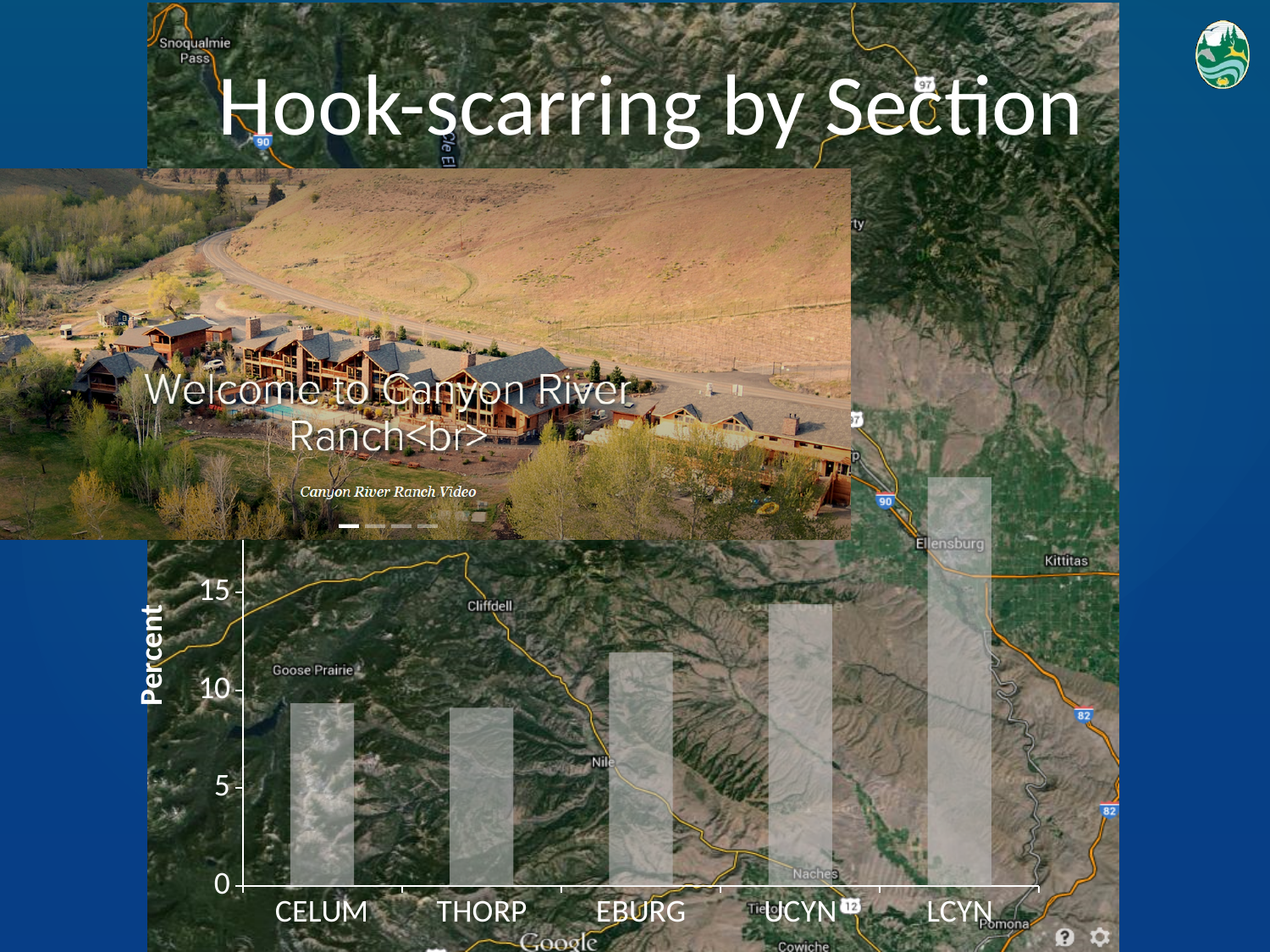
Is the value for LCYN greater or less than 15? greater Which section has the highest hook-scarring percent? LCYN Do the values rise or fall from THORP to LCYN along the x axis? rise Is the value for THORP greater or less than 5? greater Is the value for UCYN greater or less than 15? less What is the label of the y axis of the chart? Percent What type of chart is shown on the slide? bar chart How many sections (categories) are shown on the x axis of the chart? 5 Which has a higher hook-scarring percent, EBURG or UCYN? UCYN What is the title of the chart? Hook-scarring by Section